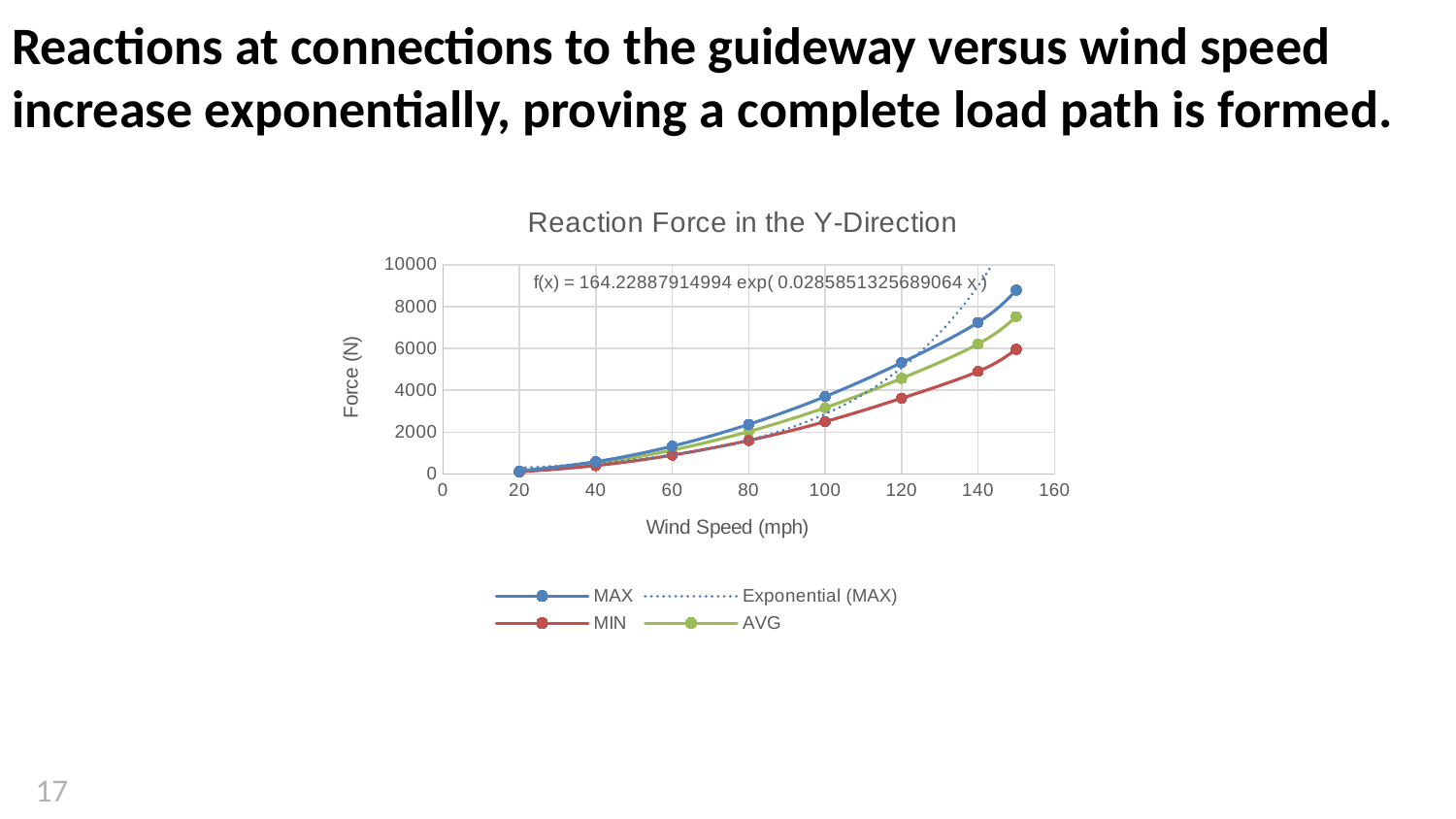
At 100 mph, is the MAX force greater or less than 4000 N? less What kind of chart is shown on the slide? line chart At 120 mph, is the MIN force greater or less than 4000 N? less Which series has the highest force at 150 mph? MAX How many data points are plotted for the MAX series? 8 What is the label of the x axis? Wind Speed (mph) Which series has the lowest force at 150 mph? MIN How many entries does the chart legend list? 4 Do the force values rise or fall as wind speed increases? rise What is the title of the chart? Reaction Force in the Y-Direction At 150 mph, is the MAX force greater or less than 8000 N? greater At 150 mph, which is larger, the MAX force or the MIN force? MAX